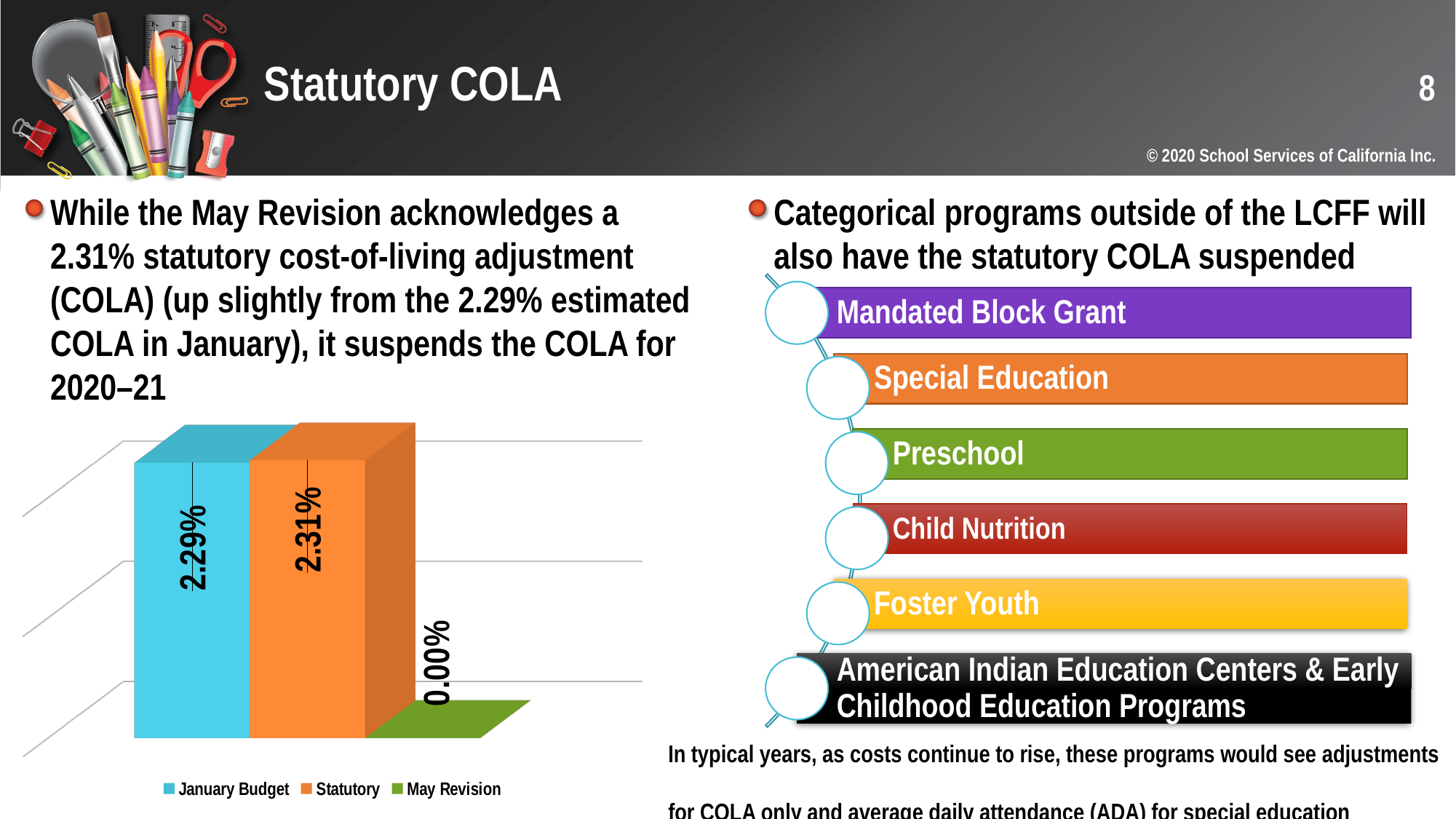
Which is larger, the Statutory value or the January Budget value? Statutory Which colour represents May Revision in the chart legend? Green Which series has the lowest value in the bar chart? May Revision What is the difference between the Statutory value and the January Budget value? 0.02% How many series does the chart legend list? 3 How many bars are plotted in the chart? 3 Which series has the highest value in the bar chart? Statutory What kind of chart is shown on the slide? Bar chart What is the value for May Revision in the bar chart? 0.00% What is the value for January Budget in the bar chart? 2.29% What is the value for Statutory in the bar chart? 2.31% What is the difference between the January Budget value and the May Revision value? 2.29%